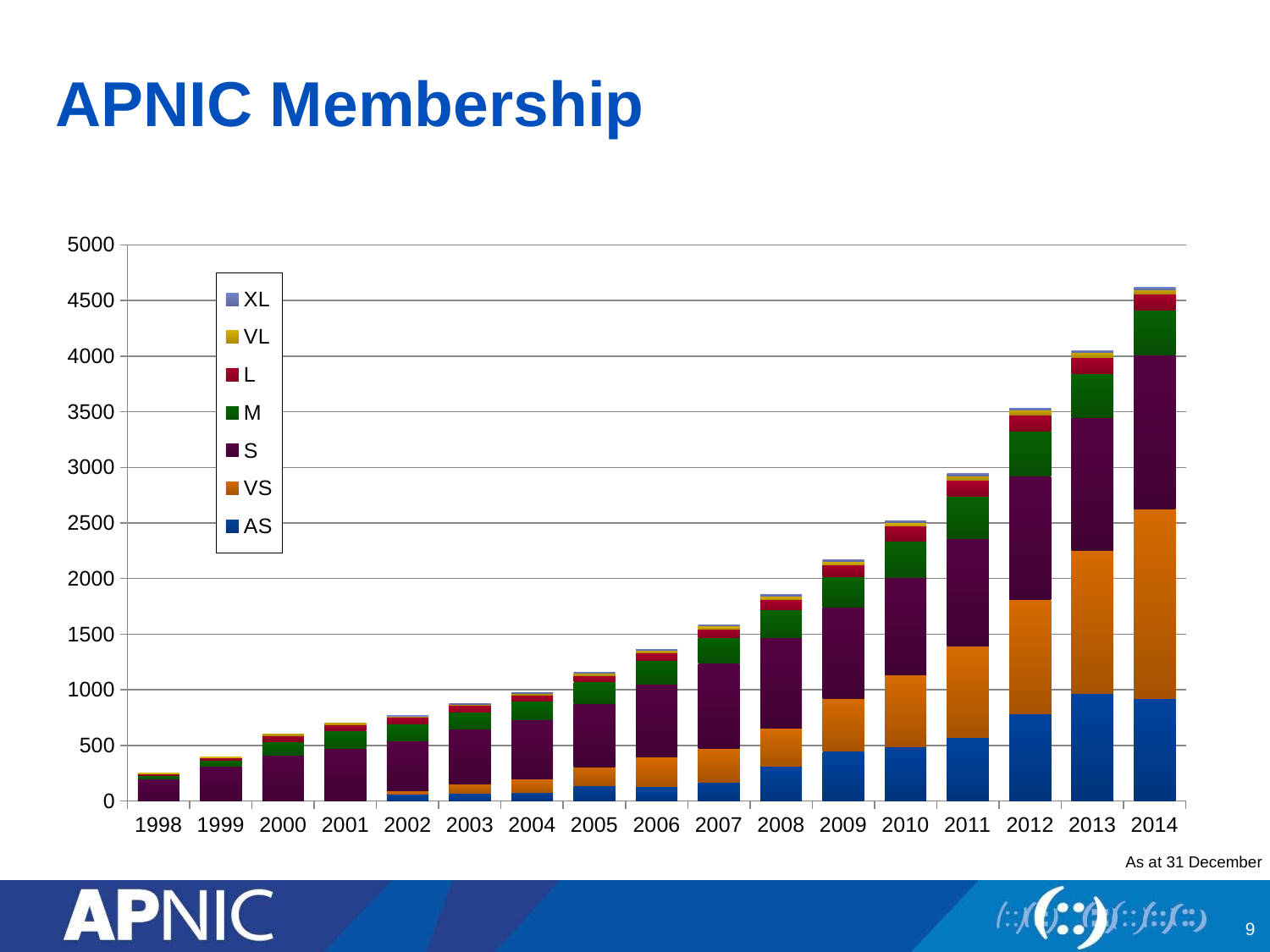
Which year has the larger total membership, 2013 or 2014? 2014 Which year has the highest total membership in the chart? 2014 What kind of chart is shown on the slide? Stacked bar chart How many series does the chart's legend list? 7 Is the total membership for 1998 greater or less than 500? less Is the total membership for 2008 greater or less than 2000? less What is the title of the chart on the slide? APNIC Membership How many years are shown along the x axis of the chart? 17 Do the total membership values rise or fall from 1998 to 2014? Rise Is the total membership for 2014 greater or less than 4000? greater Which year has the lowest total membership in the chart? 1998